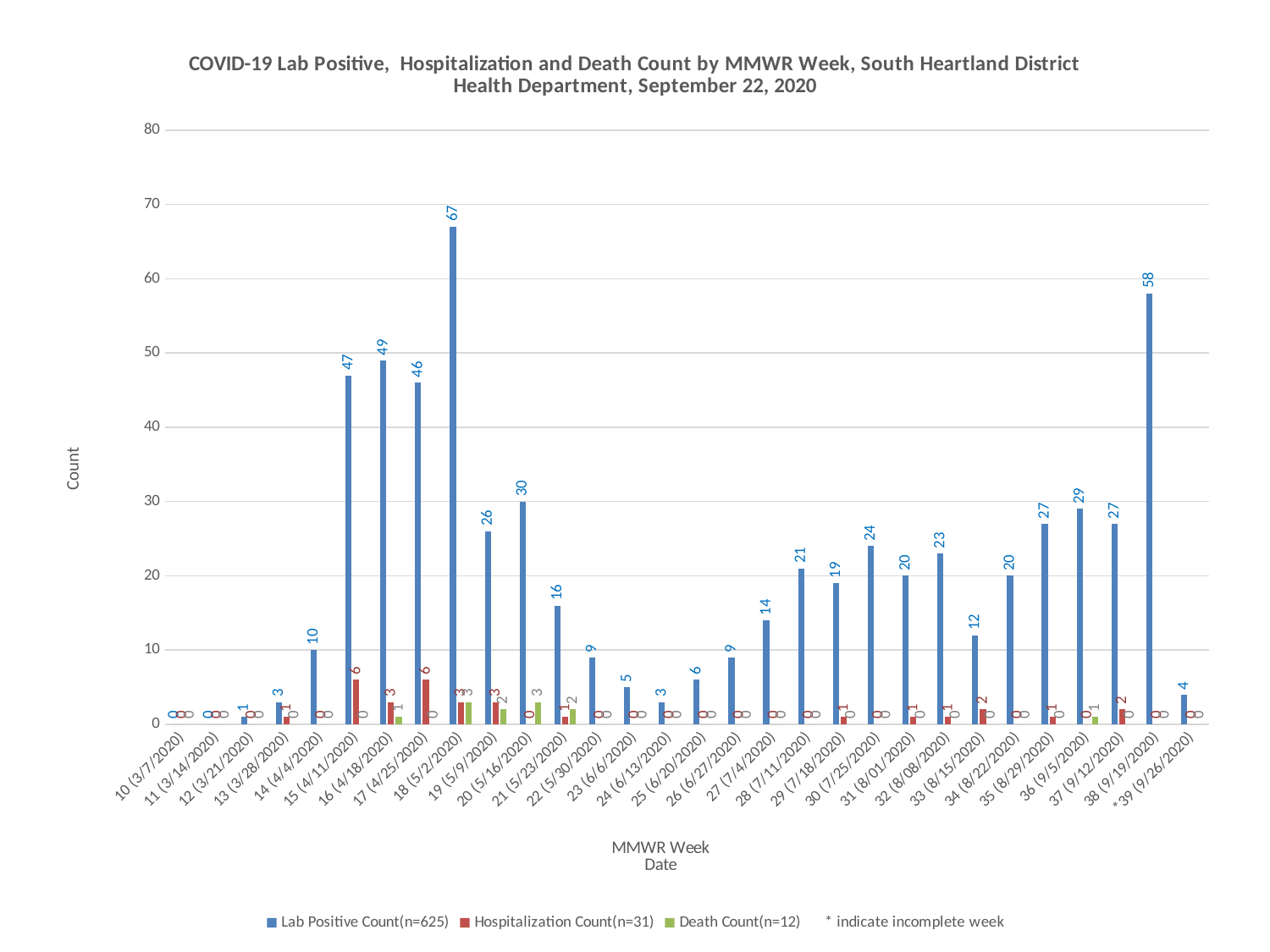
According to the legend, what is the total n for the Hospitalization Count series? 31 How many series does the legend list? 3 What is the Lab Positive Count for MMWR week 18 (5/2/2020)? 67 Which is larger, the Lab Positive Count for week 16 (4/18/2020) or week 17 (4/25/2020)? 16 (4/18/2020) What is the Hospitalization Count for MMWR week 15 (4/11/2020)? 6 How many MMWR weeks are shown on the x axis? 30 What is the Death Count for MMWR week 20 (5/16/2020)? 3 What is the Lab Positive Count for MMWR week 36 (9/5/2020)? 29 Which MMWR week has the highest Lab Positive Count? 18 (5/2/2020) Is the Lab Positive Count for week 38 (9/19/2020) greater or less than 50? greater What is the difference between the Lab Positive Count for week 18 (5/2/2020) and week 38 (9/19/2020)? 9 What type of chart is shown on the slide? bar chart